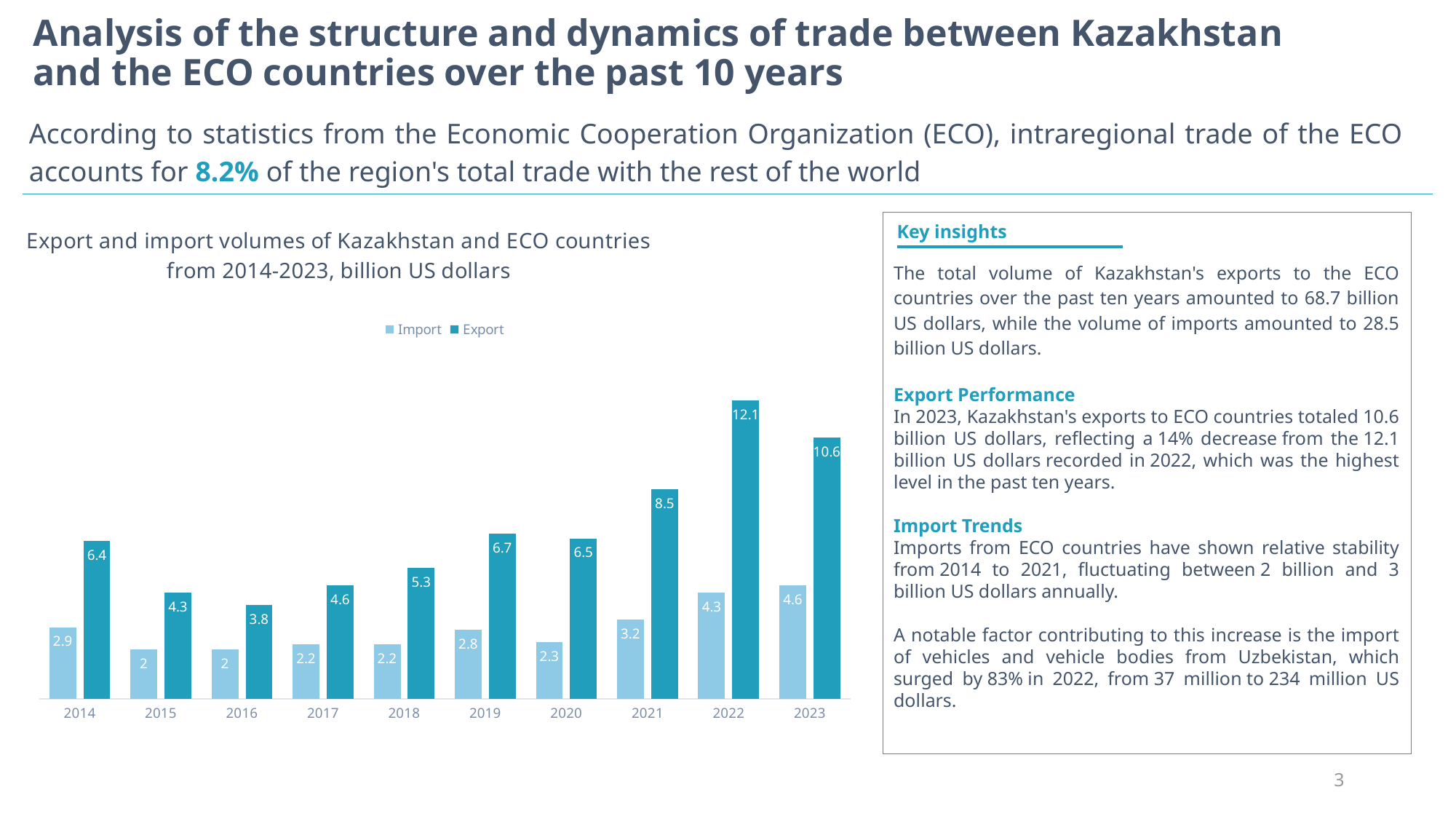
Did the Export value rise or fall from 2022 to 2023? Fall Which year had the lowest Export value? 2016 What is the difference between the Export and Import values in 2023? 6 Which is larger, the Export value in 2018 or the Export value in 2020? Export value in 2020 What was the Export value in 2022? 12.1 How many series does the chart legend list? 2 What kind of chart is shown on the slide? Bar chart What was the Export value in 2016? 3.8 What are the two series named in the chart legend? Import and Export How many years are shown on the x axis of the chart? 10 Which year had the highest Export value? 2022 What was the Import value in 2019? 2.8